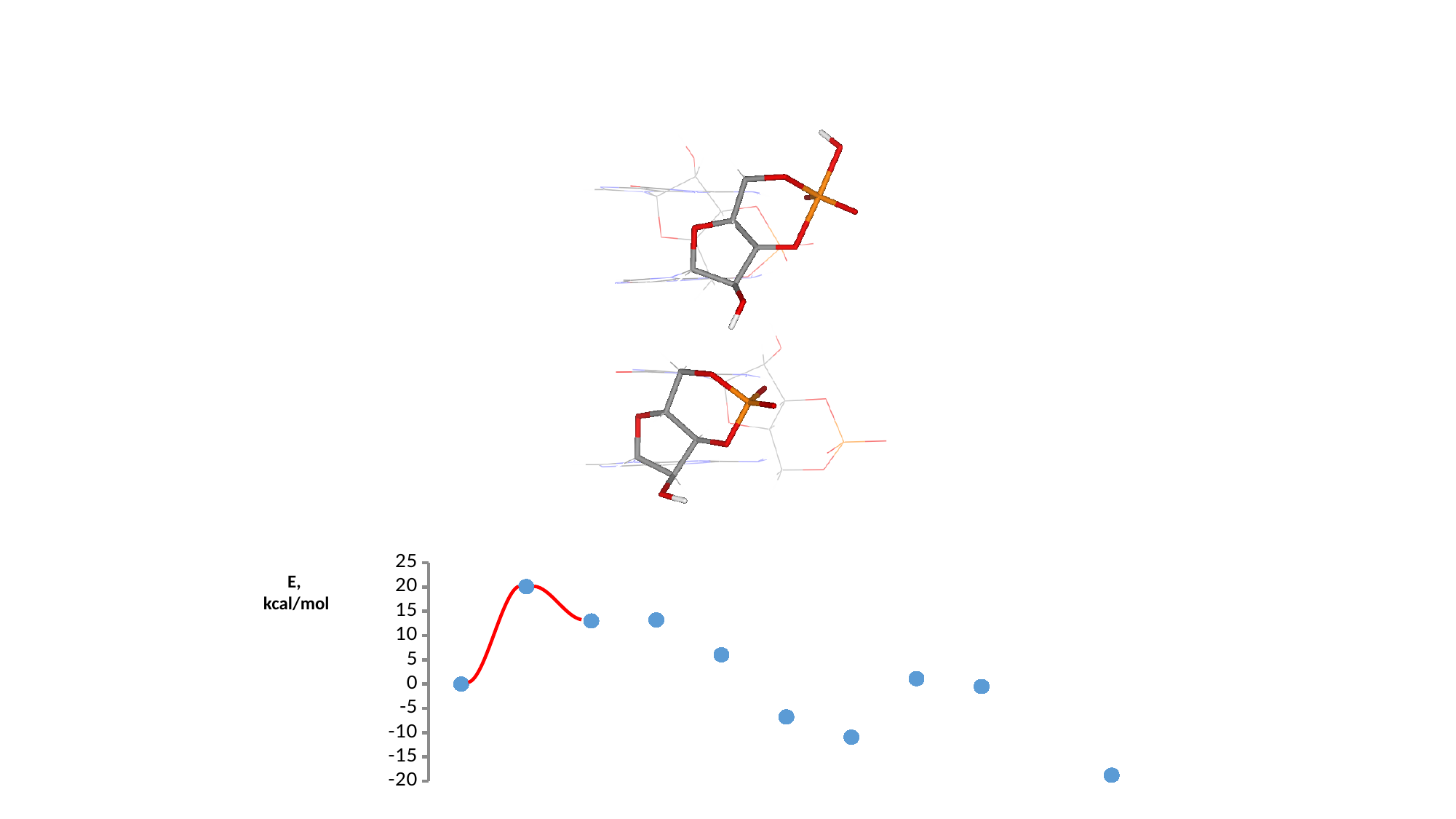
Is the value of the second point from the left greater or less than 10? greater What is the highest value shown on the vertical axis of the chart? 25 What kind of chart is shown at the bottom of the slide? scatter chart Is the lowest point on the chart greater or less than -15 kcal/mol? less Which point is the lowest on the chart: the leftmost point or the rightmost point? the rightmost point How many data points are plotted on the chart? 10 Which point on the chart has the highest energy value: the second point from the left or the rightmost point? the second point from the left Is the value of the rightmost point on the chart greater or less than 0? less What is the label of the vertical axis of the chart? E, kcal/mol Does the rightmost point on the chart lie above or below the leftmost point? below What colour is the curve drawn through the first three points of the chart? red